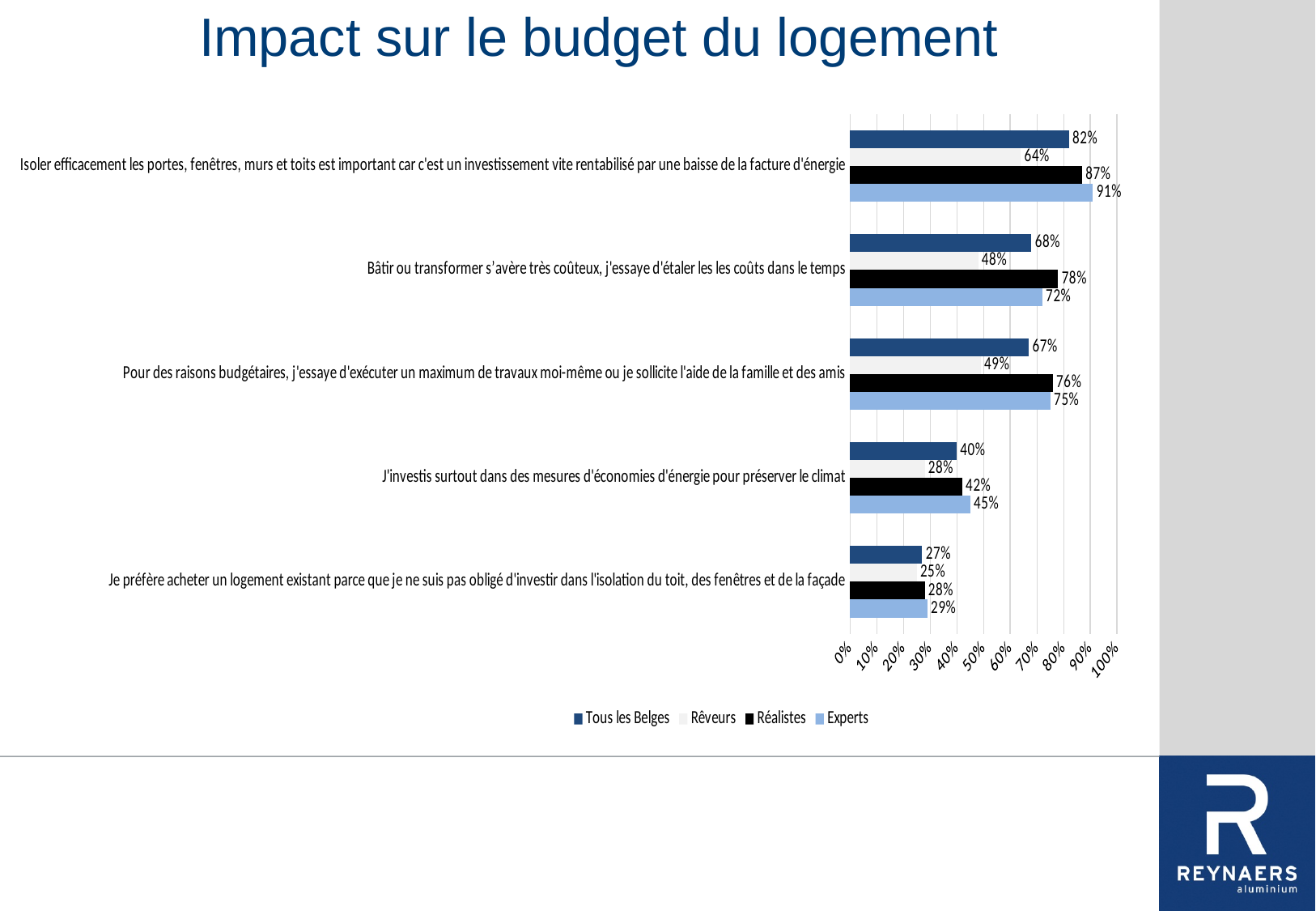
How many statements (categories) are shown on the chart? 5 Which series has the lowest value on the statement "Pour des raisons budgétaires, j'essaye d'exécuter un maximum de travaux moi-même ou je sollicite l'aide de la famille et des amis"? Rêveurs What is the value for Experts on the statement "Isoler efficacement les portes, fenêtres, murs et toits est important car c'est un investissement vite rentabilisé par une baisse de la facture d'énergie"? 91% How many series does the legend list? 4 What is the value for Rêveurs on the statement "Bâtir ou transformer s'avère très coûteux, j'essaye d'étaler les les coûts dans le temps"? 48% What is the value for Réalistes on the statement "Je préfère acheter un logement existant parce que je ne suis pas obligé d'investir dans l'isolation du toit, des fenêtres et de la façade"? 28% What is the title of the slide? Impact sur le budget du logement What is the value for Tous les Belges on the statement "J'investis surtout dans des mesures d'économies d'énergie pour préserver le climat"? 40% What is the difference between the Experts and Rêveurs values on the statement "Isoler efficacement les portes, fenêtres, murs et toits est important car c'est un investissement vite rentabilisé par une baisse de la facture d'énergie"? 27% Which series has the highest value on the statement "Bâtir ou transformer s'avère très coûteux, j'essaye d'étaler les les coûts dans le temps"? Réalistes Which is larger on the statement "J'investis surtout dans des mesures d'économies d'énergie pour préserver le climat": the value for Réalistes or the value for Experts? Experts What kind of chart is shown on the slide? Bar chart